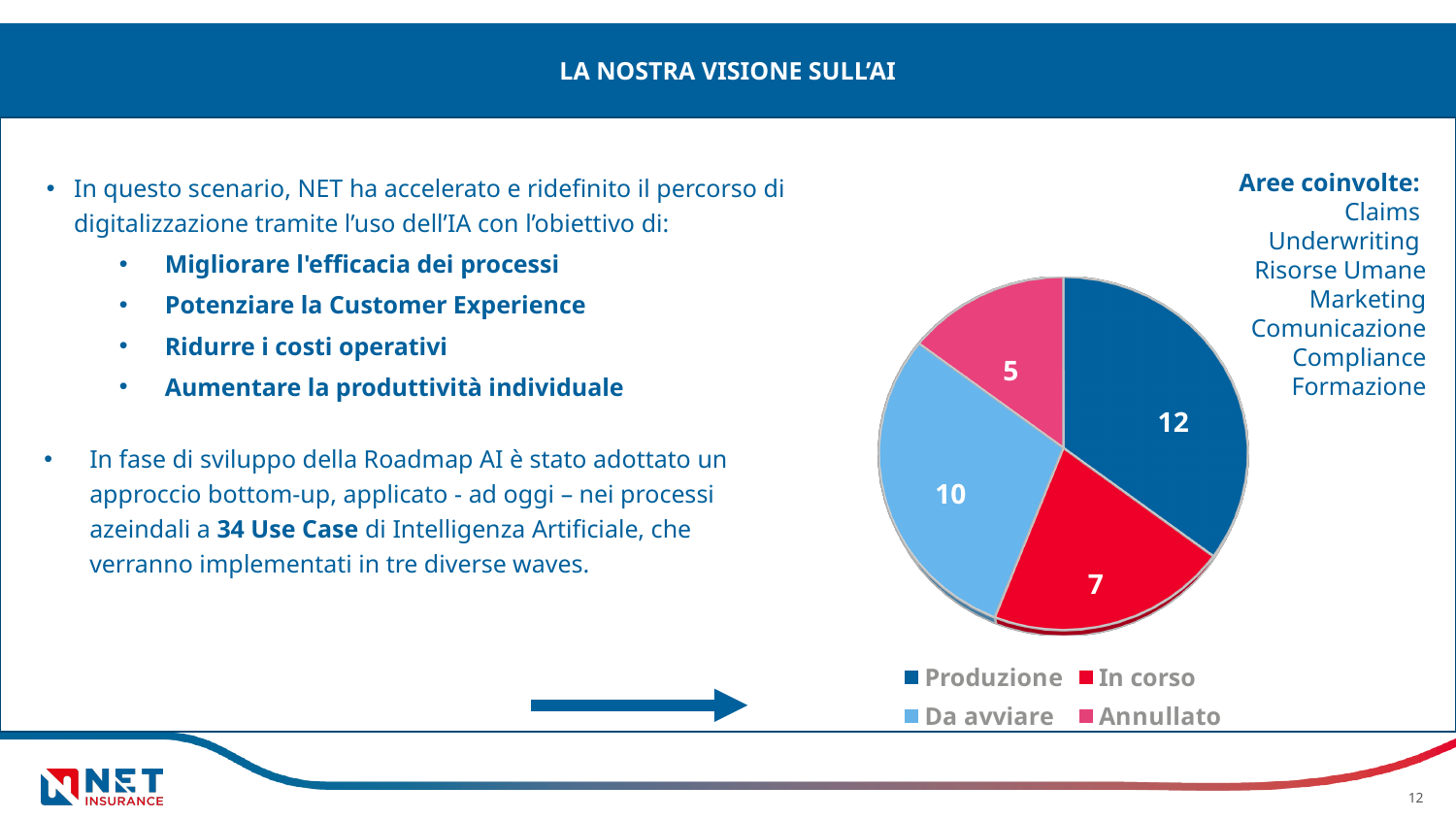
What is the value for Annullato in the pie chart? 5 What is the value for Produzione in the pie chart? 12 What is the total of all the slices in the pie chart? 34 What is the value for In corso in the pie chart? 7 What colour is the Da avviare slice in the pie chart? light blue Which category has the smallest slice in the pie chart? Annullato Which is larger, the value for Da avviare or the value for In corso? Da avviare What kind of chart is shown on the slide? pie chart Which category has the largest slice in the pie chart? Produzione What is the value for Da avviare in the pie chart? 10 How many categories does the pie chart have? 4 What is the difference between the values for Produzione and In corso? 5